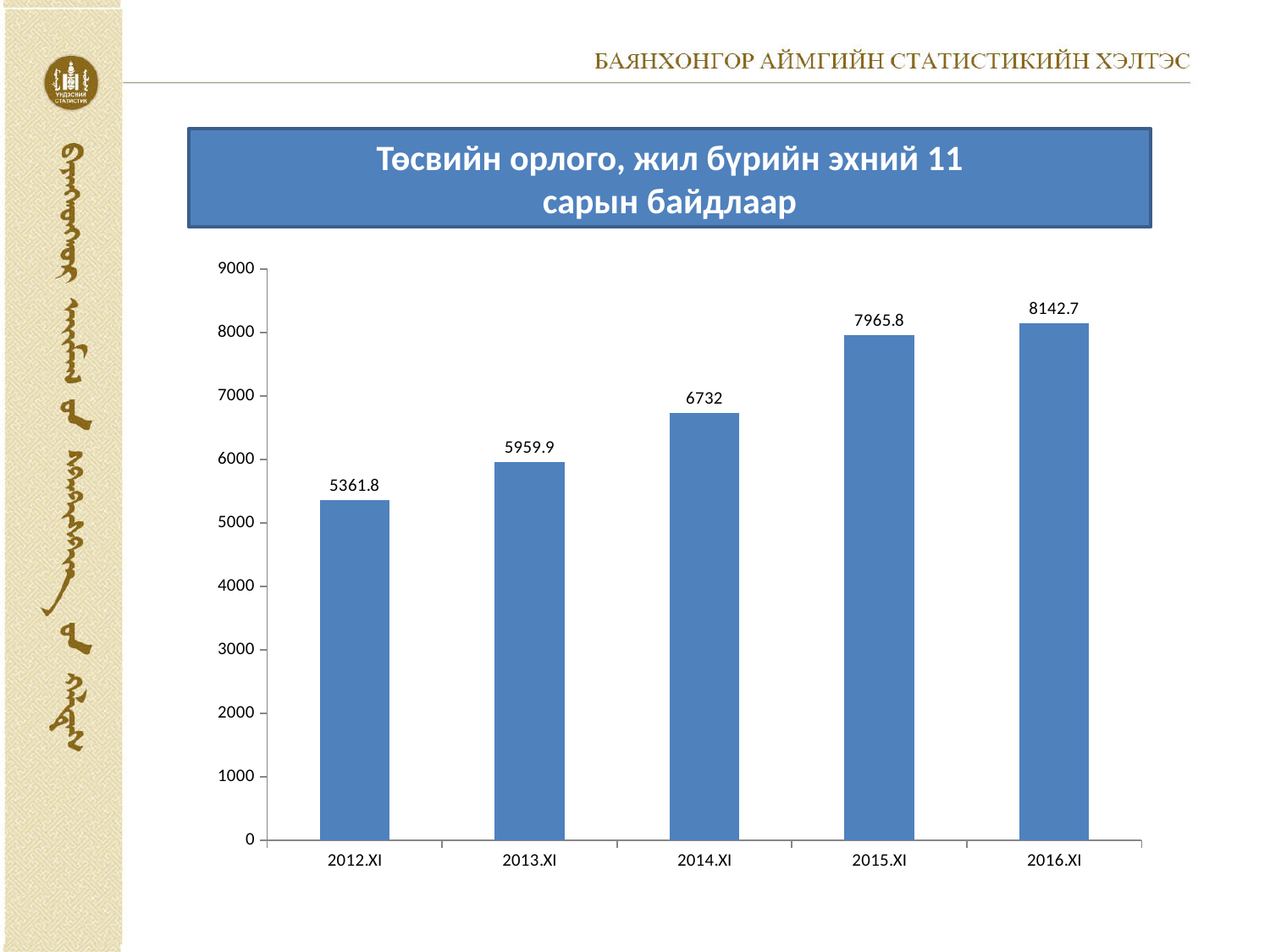
What is the difference between the values for 2016.XI and 2015.XI? 176.9 Which is larger, the value for 2013.XI or the value for 2014.XI? 2014.XI How many categories are shown on the x axis? 5 Which category has the lowest value? 2012.XI What is the value for 2016.XI? 8142.7 What is the value for 2014.XI? 6732 What kind of chart is shown on the slide? bar chart What is the difference between the values for 2013.XI and 2012.XI? 598.1 Do the values rise or fall from 2012.XI to 2016.XI? rise What is the value for 2012.XI? 5361.8 Which category has the highest value? 2016.XI Is the value for 2015.XI greater or less than 7000? greater